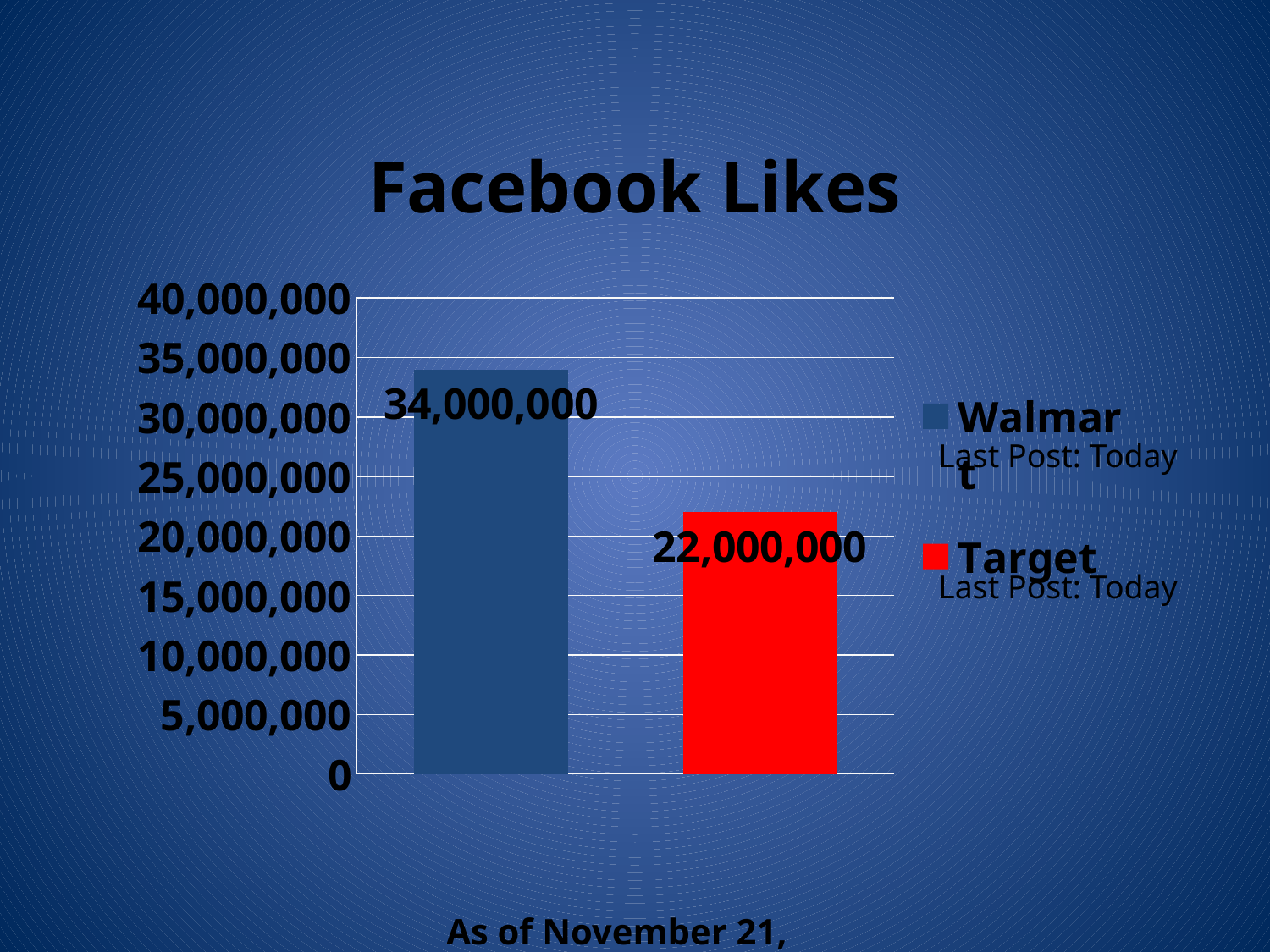
Which company has the most Facebook likes? Walmart How many entries does the legend list? 2 Is the value for Target greater or less than 25,000,000? less What is the number of Facebook likes for Target? 22,000,000 What is the number of Facebook likes for Walmart? 34,000,000 Which has more Facebook likes, Target or Walmart? Walmart Is the value for Walmart greater or less than 30,000,000? greater What is the title of the chart? Facebook Likes Which company has the fewest Facebook likes? Target How many bars are shown in the chart? 2 What kind of chart is shown on the slide? bar chart What is the difference in Facebook likes between Walmart and Target? 12,000,000